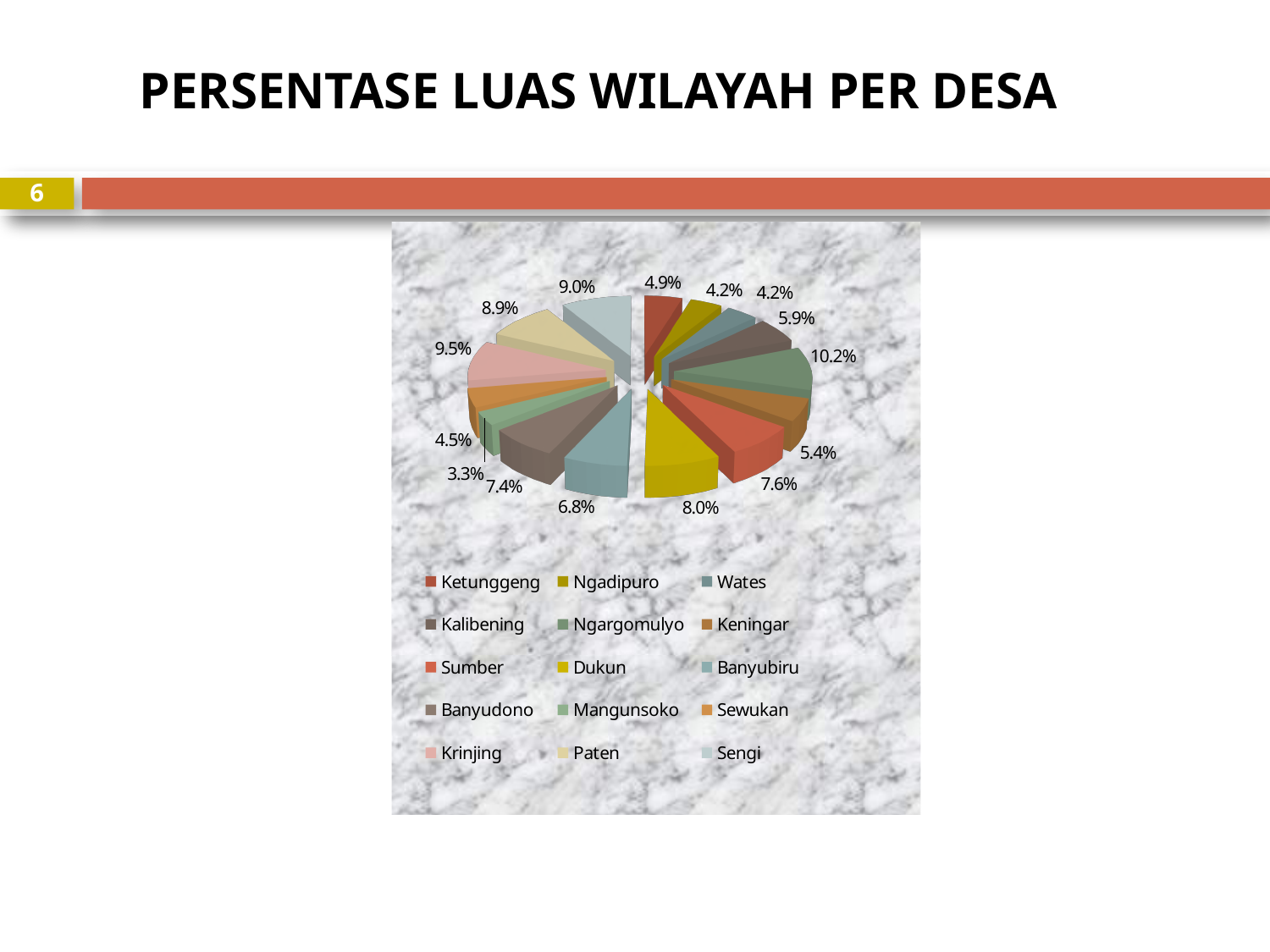
What is the title of the slide containing the pie chart? PERSENTASE LUAS WILAYAH PER DESA What is the difference in percentage points between the largest slice (10.2%) and the smallest slice (3.3%)? 6.9 What percentage of the area does Ketunggeng account for? 4.9% What percentage of the area does Dukun account for? 8.0% How many slices (villages) does the pie chart have? 15 What percentage of the area does Krinjing account for? 9.5% Which village has the largest share of the area in the pie chart? Ngargomulyo What type of chart is shown on the slide? pie chart Which village has the smallest share of the area in the pie chart? Mangunsoko What is the largest percentage shown on the pie chart? 10.2% What is the smallest percentage shown on the pie chart? 3.3% Which has a larger share, Sumber (7.6%) or Banyubiru (6.8%)? Sumber